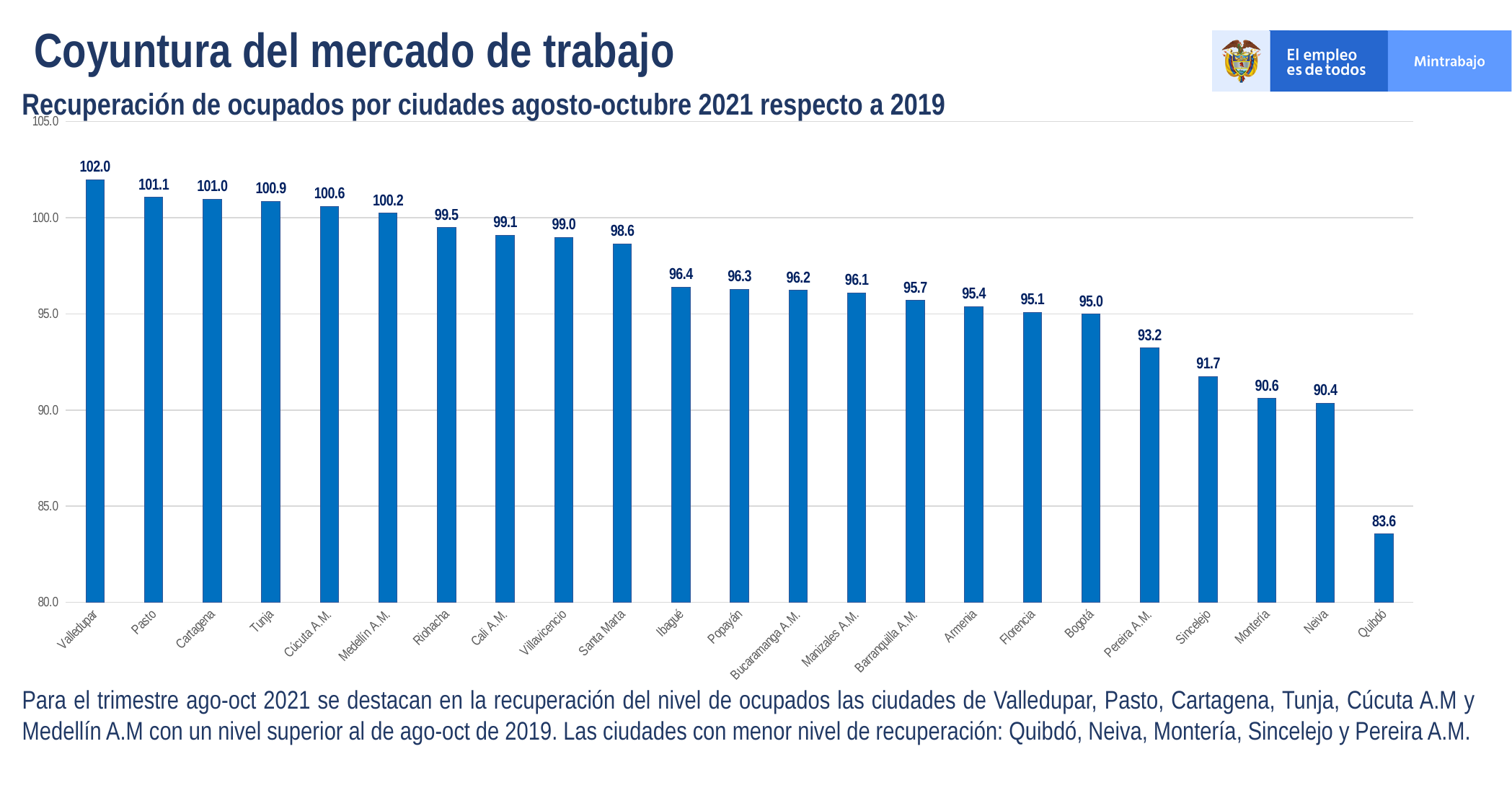
What is the value for Riohacha? 99.5 Which city has the highest value? Valledupar Which is larger, the value for Santa Marta or the value for Ibagué? Santa Marta Is the value for Neiva greater or less than 95.0? less Which city has the lowest value? Quibdó What is the value for Bogotá? 95.0 What is the difference between the values for Valledupar and Quibdó? 18.4 What is the value for Pereira A.M.? 93.2 What is the difference between the values for Cali A.M. and Bogotá? 4.1 What kind of chart is shown on the slide? bar chart Do the values rise or fall from left to right along the x axis? fall How many cities are shown on the chart? 23